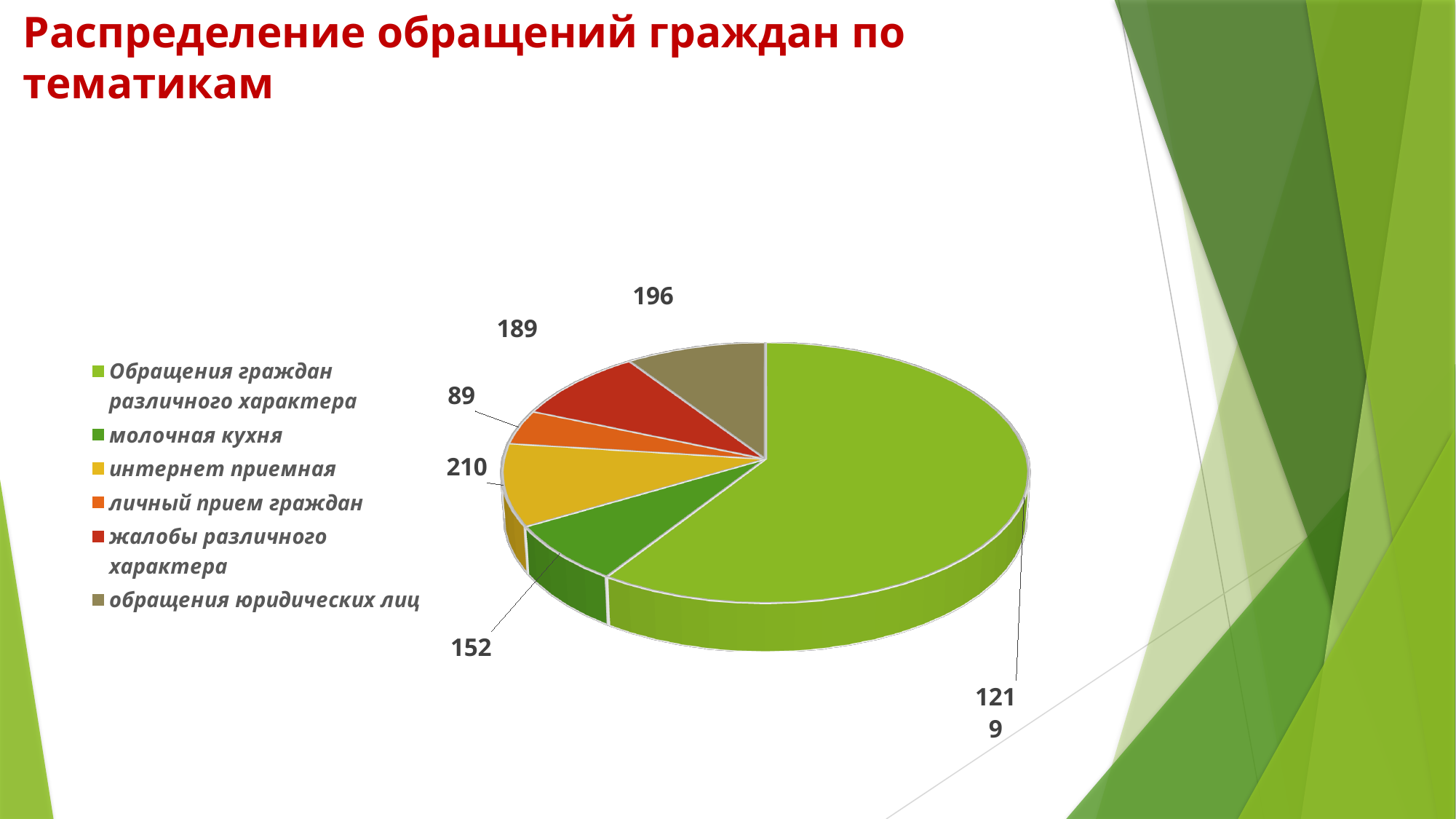
What is the value for 'личный прием граждан'? 89 What is the difference between the values for 'интернет приемная' and 'жалобы различного характера'? 21 Which category has the smallest slice of the pie? личный прием граждан What is the value for 'интернет приемная'? 210 Which is larger: the value for 'обращения юридических лиц' or for 'жалобы различного характера'? обращения юридических лиц What is the value for 'жалобы различного характера'? 189 What is the value for 'Обращения граждан различного характера'? 1219 Which category has the largest slice of the pie? Обращения граждан различного характера What is the title of the chart on the slide? Распределение обращений граждан по тематикам What is the value for 'молочная кухня'? 152 What kind of chart is shown on the slide? pie chart How many categories does the pie chart have? 6